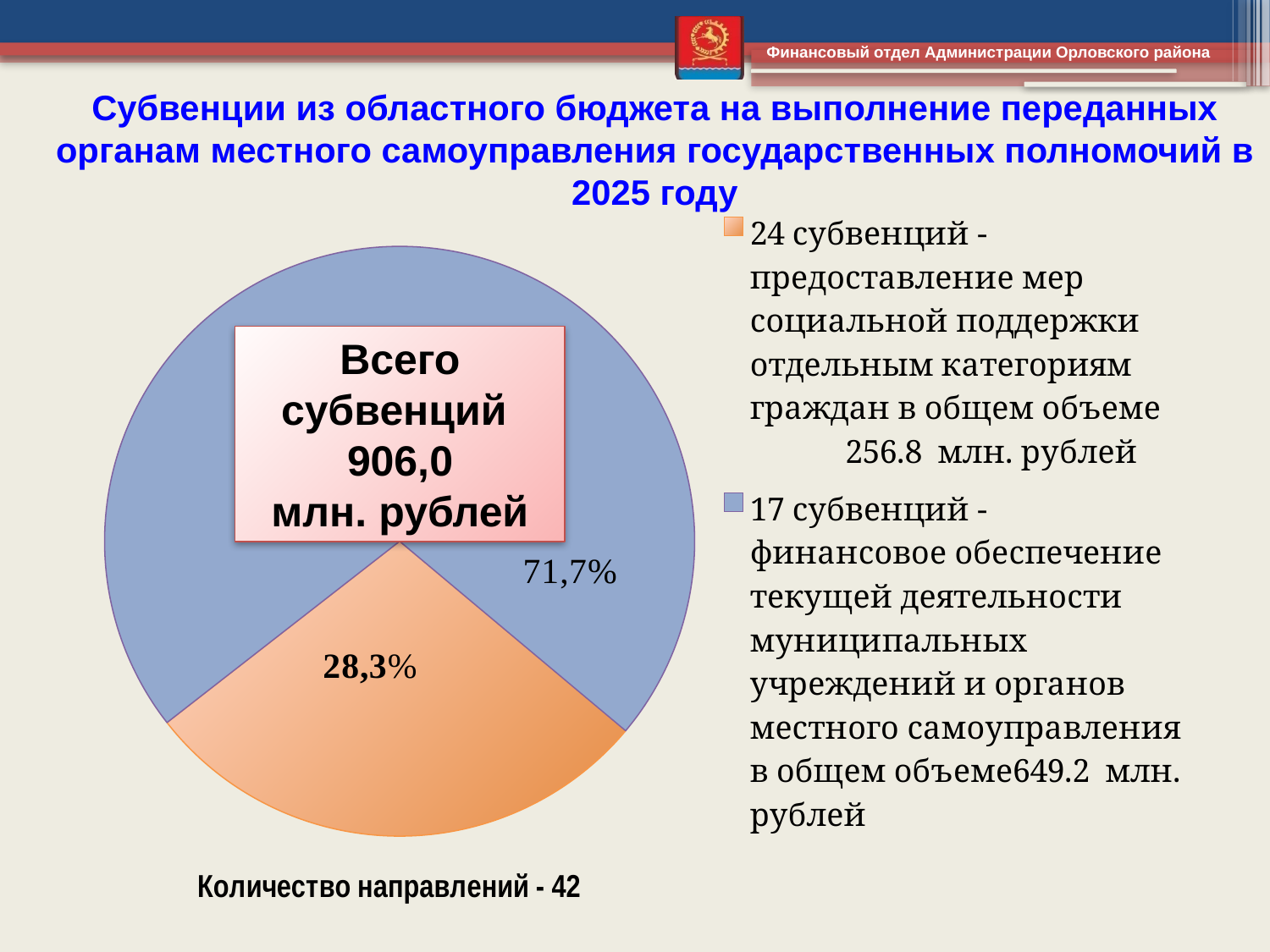
How many slices does the pie chart have? 2 What share of the pie does the orange slice (24 субвенций - предоставление мер социальной поддержки) represent? 28,3% What total amount of subventions is shown in the box at the centre of the pie chart? 906,0 млн. рублей What share of the pie does the blue slice (17 субвенций - финансовое обеспечение текущей деятельности) represent? 71,7% What is the total volume of the 24 subventions for social support measures, according to the legend text? 256.8 млн. рублей Which slice of the pie is the smallest? 24 субвенций - предоставление мер социальной поддержки отдельным категориям граждан What is the difference in percentage points between the blue slice (71,7%) and the orange slice (28,3%)? 43,4 Which slice of the pie is the largest? 17 субвенций - финансовое обеспечение текущей деятельности муниципальных учреждений и органов местного самоуправления What colour is the slice representing the 24 subventions for social support measures? orange Which is larger: the share for social support subventions (24 субвенций) or the share for financial support of municipal institutions (17 субвенций)? 17 субвенций - финансовое обеспечение текущей деятельности What is the total volume of the 17 subventions for financial support of municipal institutions, according to the legend text? 649.2 млн. рублей What kind of chart is shown on the slide? pie chart